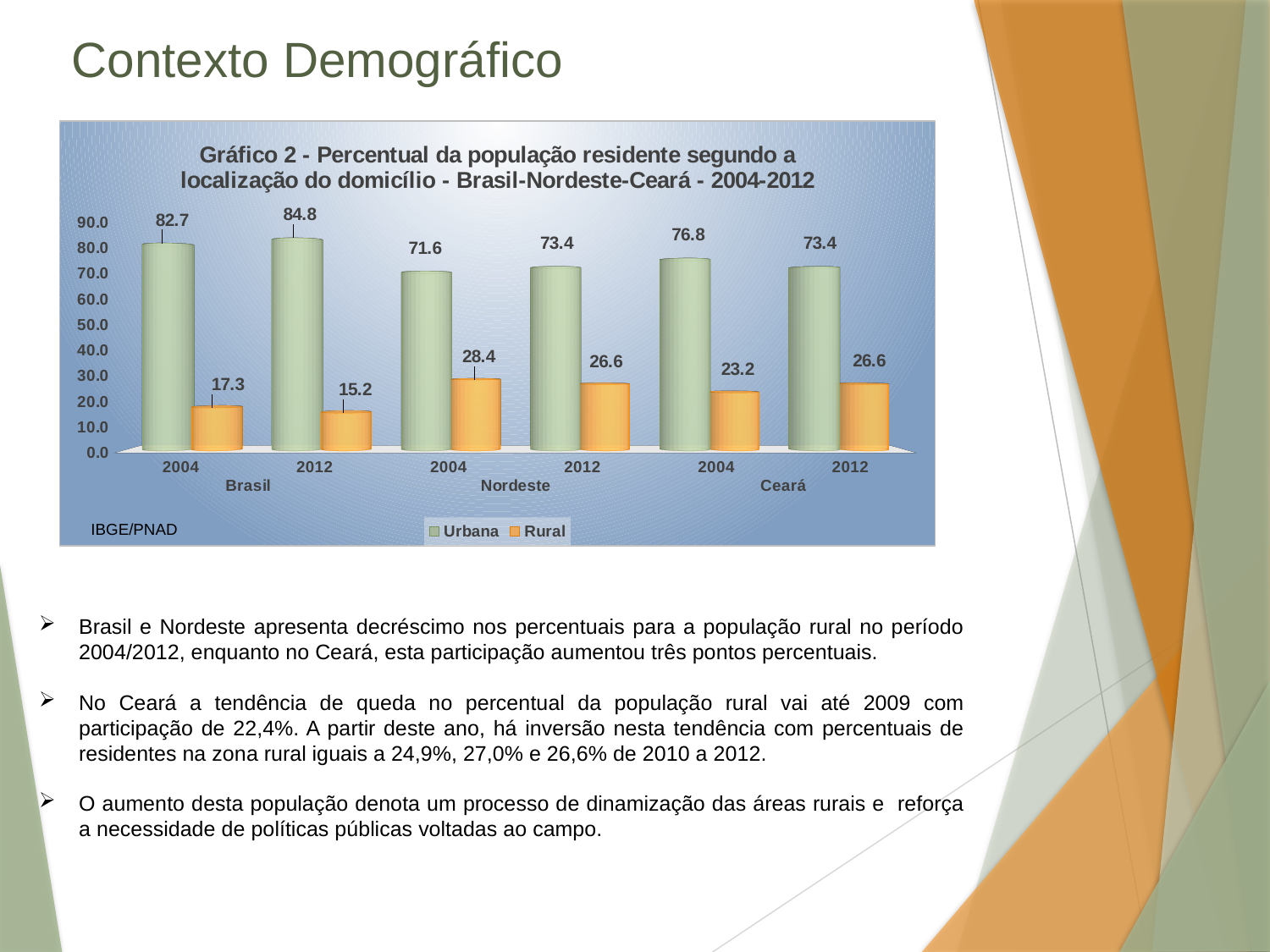
What source is cited in the bottom left of the chart? IBGE/PNAD Which is larger, the Urbana value for Nordeste in 2004 or for Ceará in 2004? Ceará 2004 Which category has the lowest Rural value? Brasil 2012 Does the Rural value for Brasil rise or fall from 2004 to 2012? Fall Which category has the highest Urbana value? Brasil 2012 What is the Rural value for Nordeste in 2004? 28.4 How many series does the legend list? 2 What is the Rural value for Ceará in 2012? 26.6 What kind of chart is shown? Bar chart How many categories are shown on the x axis? 6 What is the difference between the Rural values for Ceará in 2012 and 2004? 3.4 What is the Urbana value for Brasil in 2004? 82.7